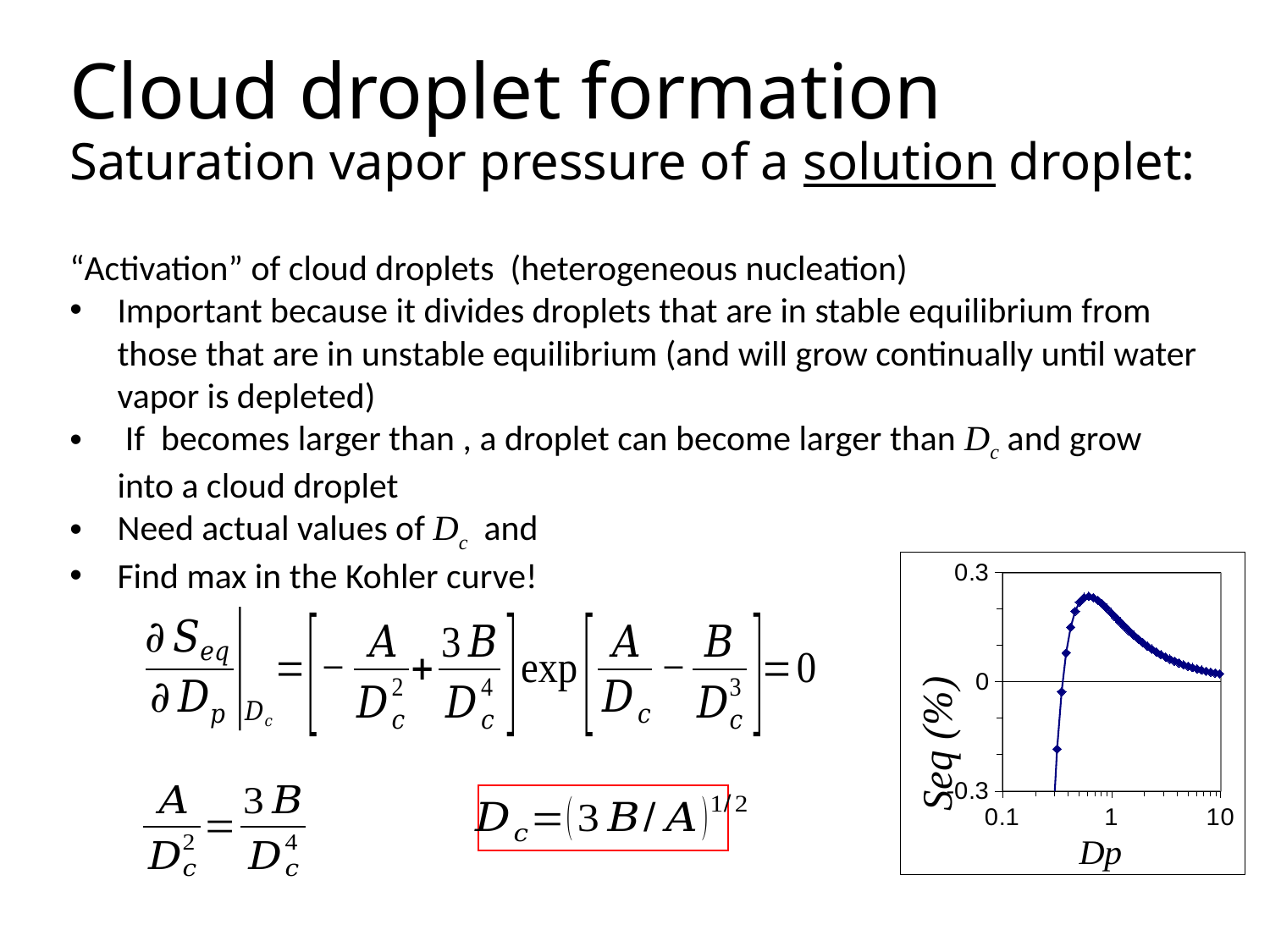
What is the label of the y-axis of the chart? Seq (%) Is the Dp at which the curve reaches its peak greater or less than 1? less How does the curve behave as Dp increases across the whole plotted range? rises to a peak, then falls What kind of chart is shown on the slide? line chart Is the maximum value of the curve greater or less than 0? greater What is the label of the x-axis of the chart? Dp Does the curve rise or fall as Dp increases from 1 to 10? fall Is the maximum value of the curve greater or less than 0.3? less